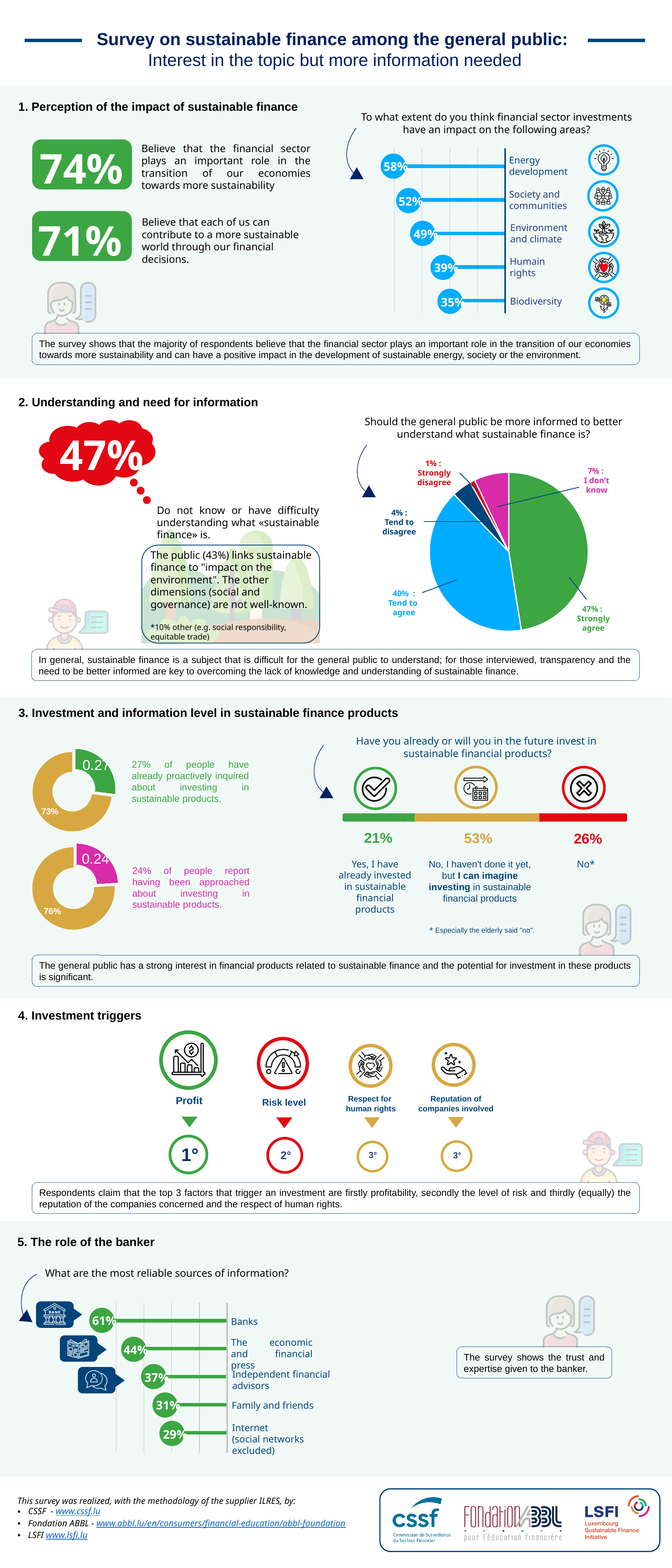
In the chart 'To what extent do you think financial sector investments have an impact on the following areas?', which area has the lowest value? Biodiversity In the chart 'What are the most reliable sources of information?', what is the value for Independent financial advisors? 37% In the chart 'To what extent do you think financial sector investments have an impact on the following areas?', what is the value for Energy development? 58% In the chart 'Have you already or will you in the future invest in sustainable financial products?', what is the difference between those who can imagine investing and those who have already invested? 32% In the chart 'What are the most reliable sources of information?', which source has the highest value? Banks In the pie chart 'Should the general public be more informed to better understand what sustainable finance is?', what share is 'Tend to agree'? 40% What kind of chart is used for 'Should the general public be more informed to better understand what sustainable finance is?' Pie chart How many areas are listed in the chart 'To what extent do you think financial sector investments have an impact on the following areas?' 5 In the pie chart 'Should the general public be more informed to better understand what sustainable finance is?', which response has the largest slice? Strongly agree In the pie chart 'Should the general public be more informed to better understand what sustainable finance is?', which is larger: 'I don't know' or 'Tend to disagree'? I don't know In the chart 'Have you already or will you in the future invest in sustainable financial products?', what percentage answered 'No'? 26% In the chart 'To what extent do you think financial sector investments have an impact on the following areas?', what is the difference between Society and communities and Human rights? 13%